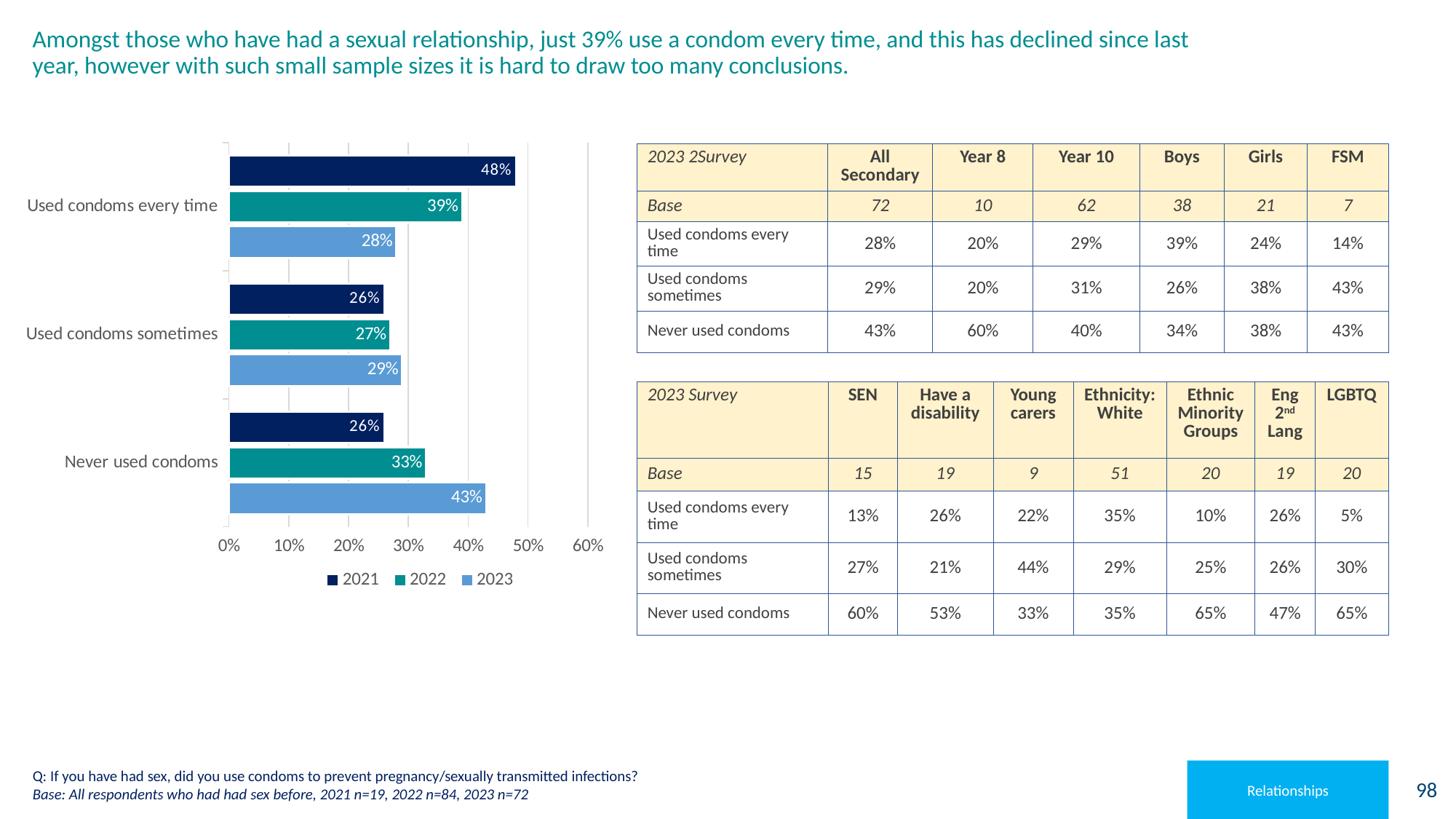
What is the 2022 value for 'Never used condoms'? 33% Which year has the highest value for 'Never used condoms'? 2023 What is the difference between the 2021 and 2023 values for 'Used condoms every time'? 20% What is the 2023 value for 'Used condoms every time'? 28% Which is larger: the 2022 value for 'Used condoms every time' or the 2022 value for 'Never used condoms'? 2022 'Used condoms every time' Which series is shown in the darkest blue colour? 2021 What is the 2023 value for 'Used condoms sometimes'? 29% Which year has the lowest value for 'Used condoms every time'? 2023 How many series does the legend list? 3 What kind of chart is shown on the slide? Bar chart What is the 2021 value for 'Used condoms every time'? 48% How many categories are shown on the chart? 3